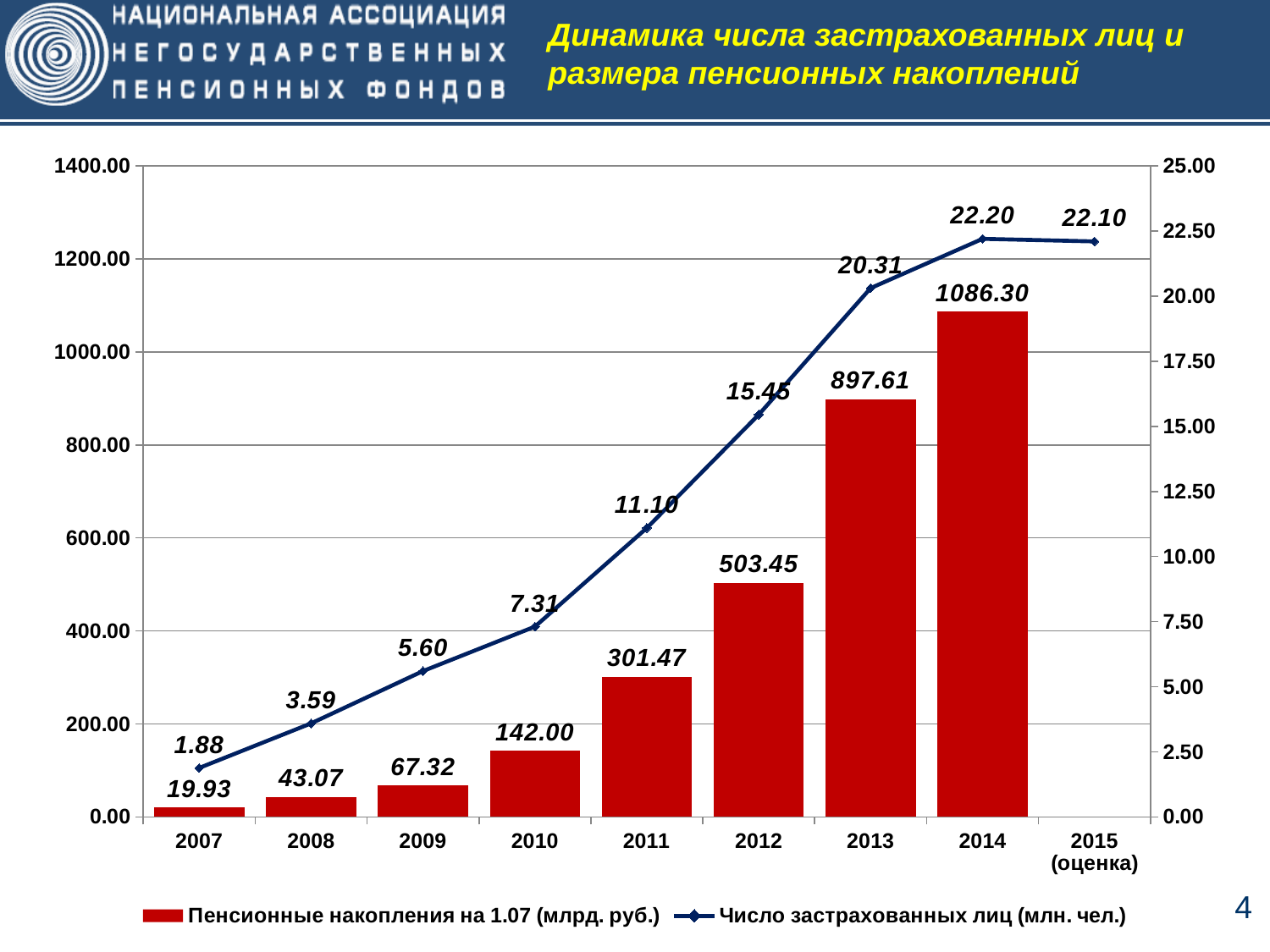
What is the value of Число застрахованных лиц (млн. чел.) for 2015 (оценка)? 22.10 How many series does the legend list? 2 Which is larger: the Число застрахованных лиц value for 2011 or for 2012? 2012 What is the value of Число застрахованных лиц (млн. чел.) for 2013? 20.31 What is the value of Пенсионные накопления на 1.07 (млрд. руб.) for 2014? 1086.30 Which year has the highest value of Число застрахованных лиц (млн. чел.)? 2014 What kind of chart is shown on the slide? Combined bar and line chart Which year has the lowest value of Пенсионные накопления на 1.07 (млрд. руб.)? 2007 What is the value of Пенсионные накопления на 1.07 (млрд. руб.) for 2012? 503.45 How many years are shown on the x axis? 9 Do the Пенсионные накопления values rise or fall from 2007 to 2014? Rise What is the difference between the Пенсионные накопления values for 2013 and 2012? 394.16